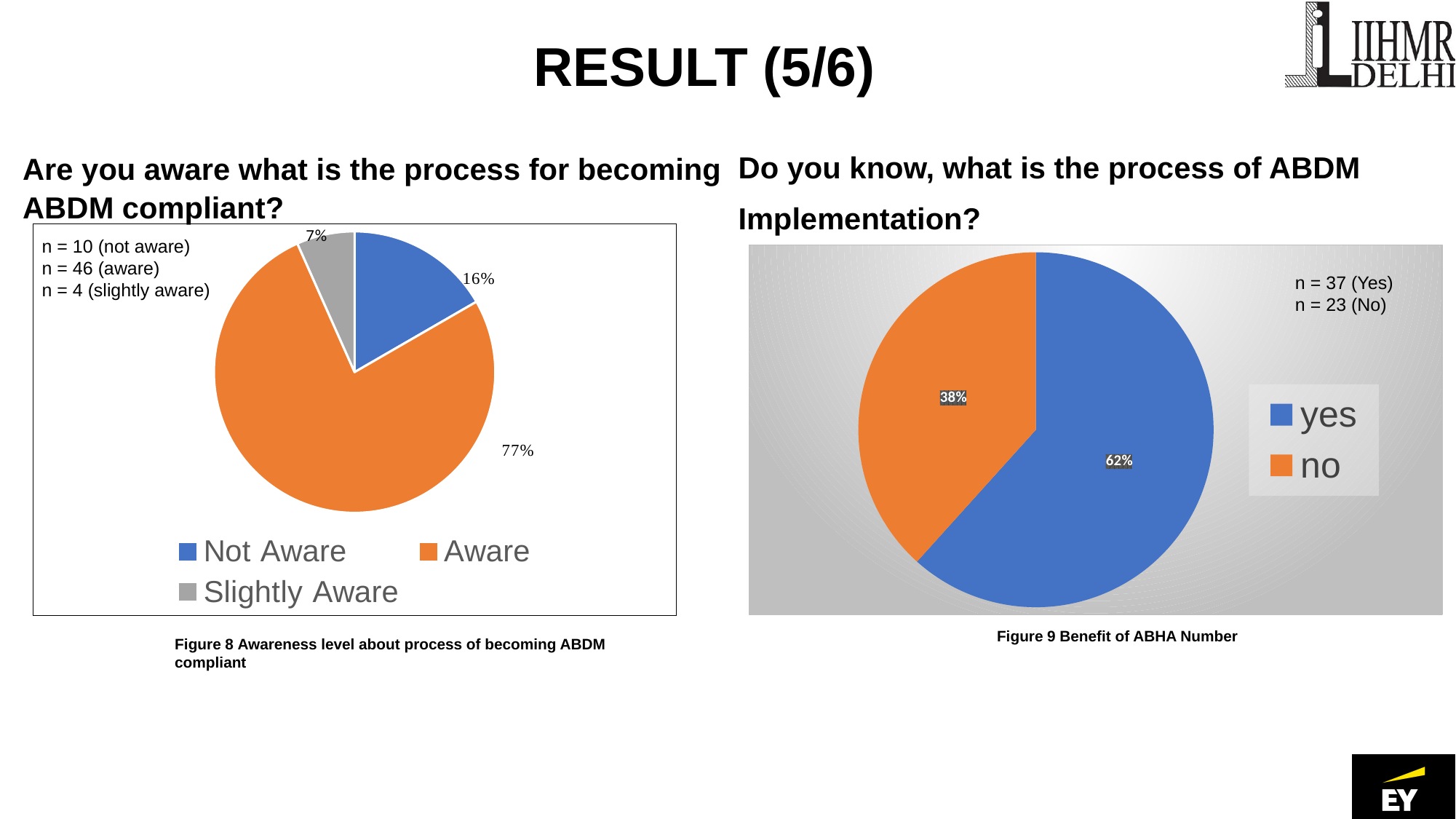
In the left pie chart (Figure 8), which category has the smallest share? Slightly Aware In the left pie chart (Figure 8), what is the difference in percentage points between Aware and Not Aware? 61 In the left pie chart (Figure 8), what percentage of respondents are Aware? 77% In the right pie chart (Figure 9), what percentage of respondents answered yes? 62% In the left pie chart (Figure 8), how many categories does the legend list? 3 In the right pie chart (Figure 9), which colour represents the 'no' slice? Orange What type of chart is shown on the right side of the slide (Figure 9)? Pie chart In the left pie chart (Figure 8), what percentage of respondents are Not Aware? 16% In the left pie chart (Figure 8), what percentage of respondents are Slightly Aware? 7% In the left pie chart (Figure 8), which category has the largest share? Aware In the right pie chart (Figure 9), which is larger, yes or no? yes In the right pie chart (Figure 9), what percentage of respondents answered no? 38%